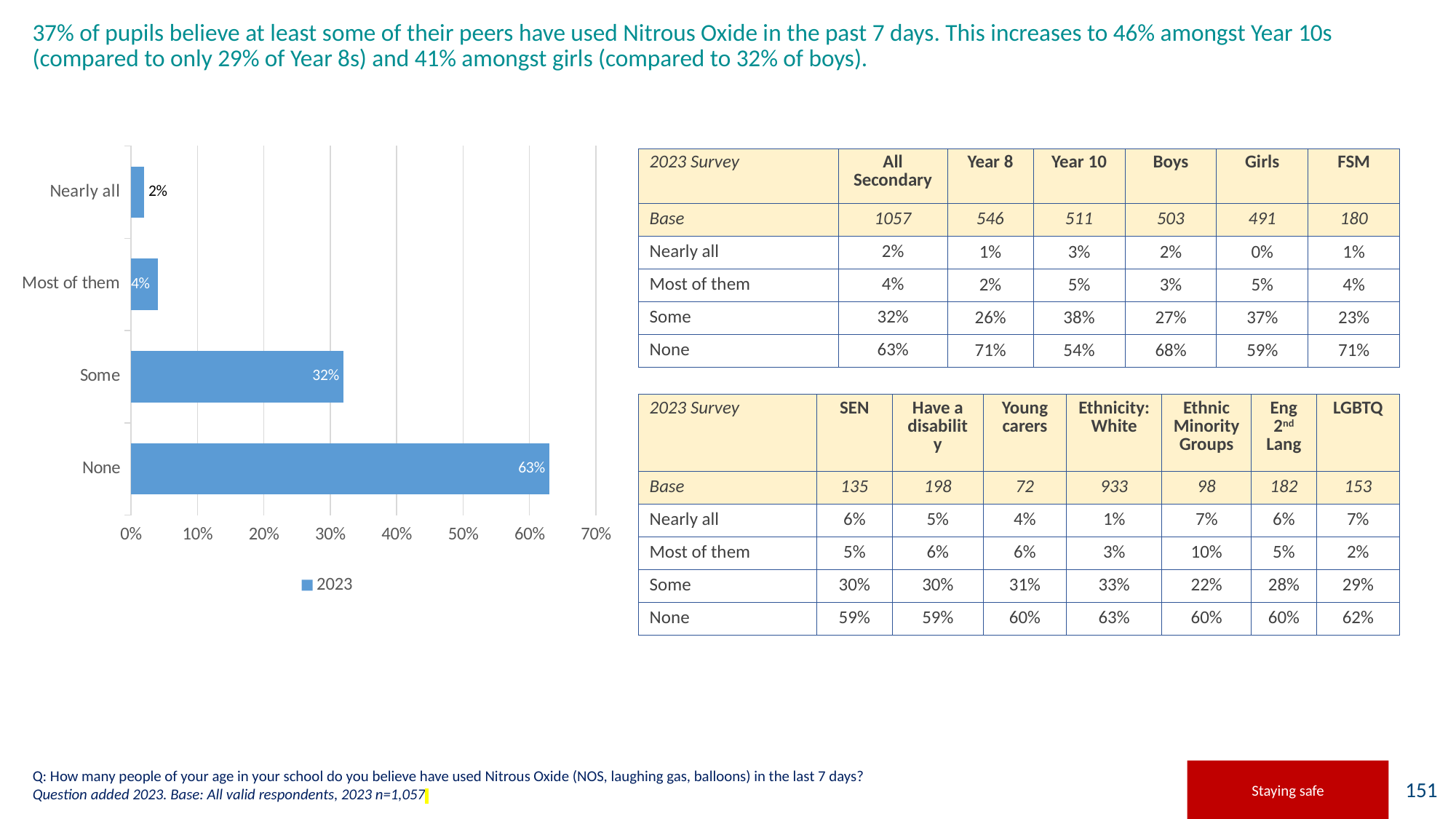
What is the value for "Nearly all" in the bar chart? 2% What is the value for "Most of them" in the bar chart? 4% What is the value for "Some" in the bar chart? 32% How many series does the legend of the bar chart list? 1 Is the value for "None" in the bar chart greater or less than 50%? greater What kind of chart is shown on the slide? Bar chart What is the difference between the values for "None" and "Some" in the bar chart? 31% Which is larger in the bar chart, the value for "Some" or the value for "Most of them"? Some What is the value for "None" in the bar chart? 63% Which category has the lowest value in the bar chart? Nearly all How many categories are shown in the bar chart? 4 Which category has the highest value in the bar chart? None